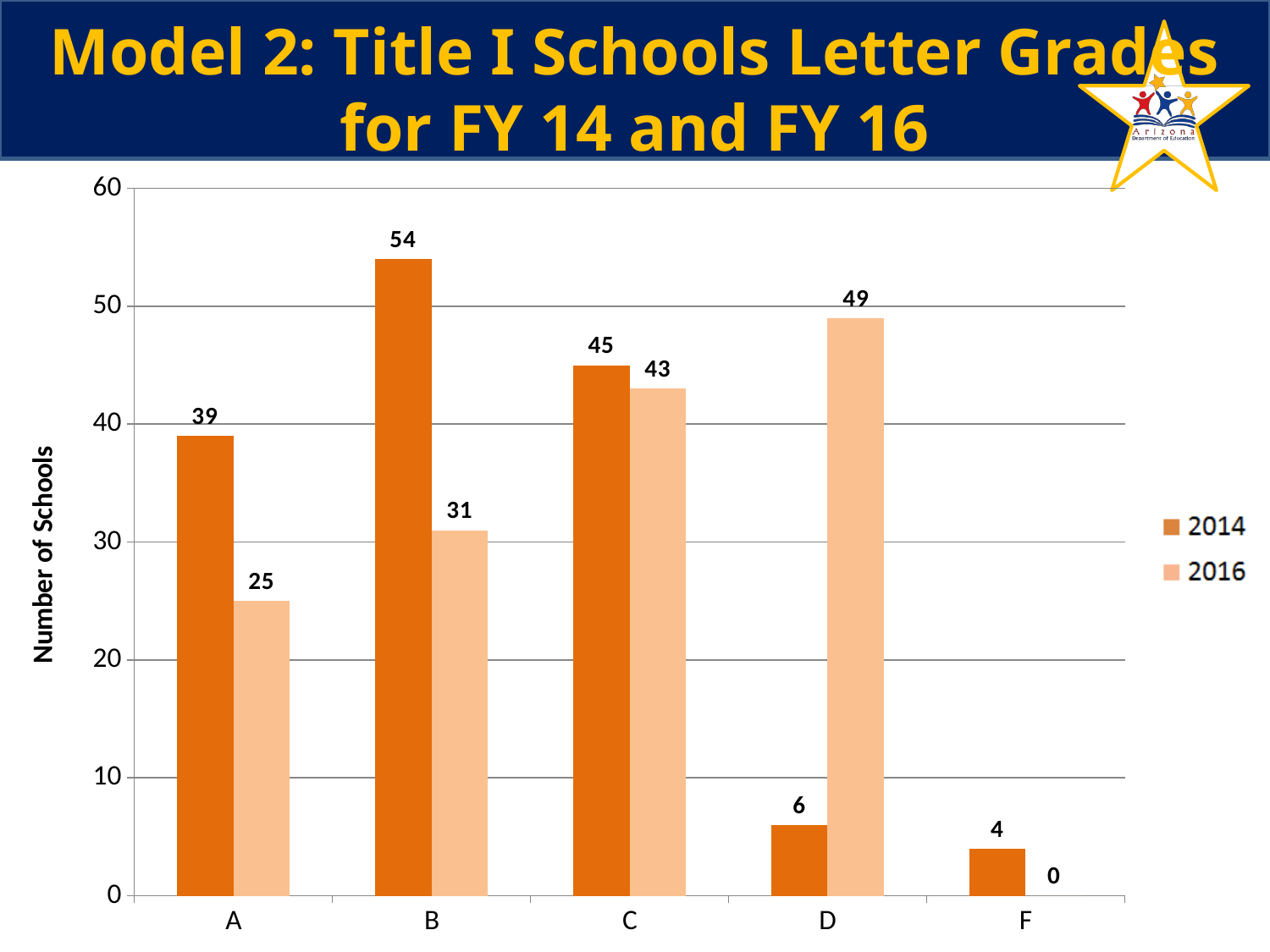
How many Title I schools received a letter grade of D in 2016? 49 What type of chart is shown on the slide? Bar chart What is the label of the y axis? Number of Schools Which letter grade had the most schools in 2014? B How many letter grade categories are shown on the x axis? 5 What is the difference between the 2014 and 2016 values for grade A? 14 What is the value for grade F in 2016? 0 Which is larger for grade C: the 2014 value or the 2016 value? 2014 By how much did the number of D schools increase from 2014 to 2016? 43 Which letter grade had the fewest schools in 2016? F How many Title I schools received a letter grade of B in 2014? 54 How many series does the legend list? 2